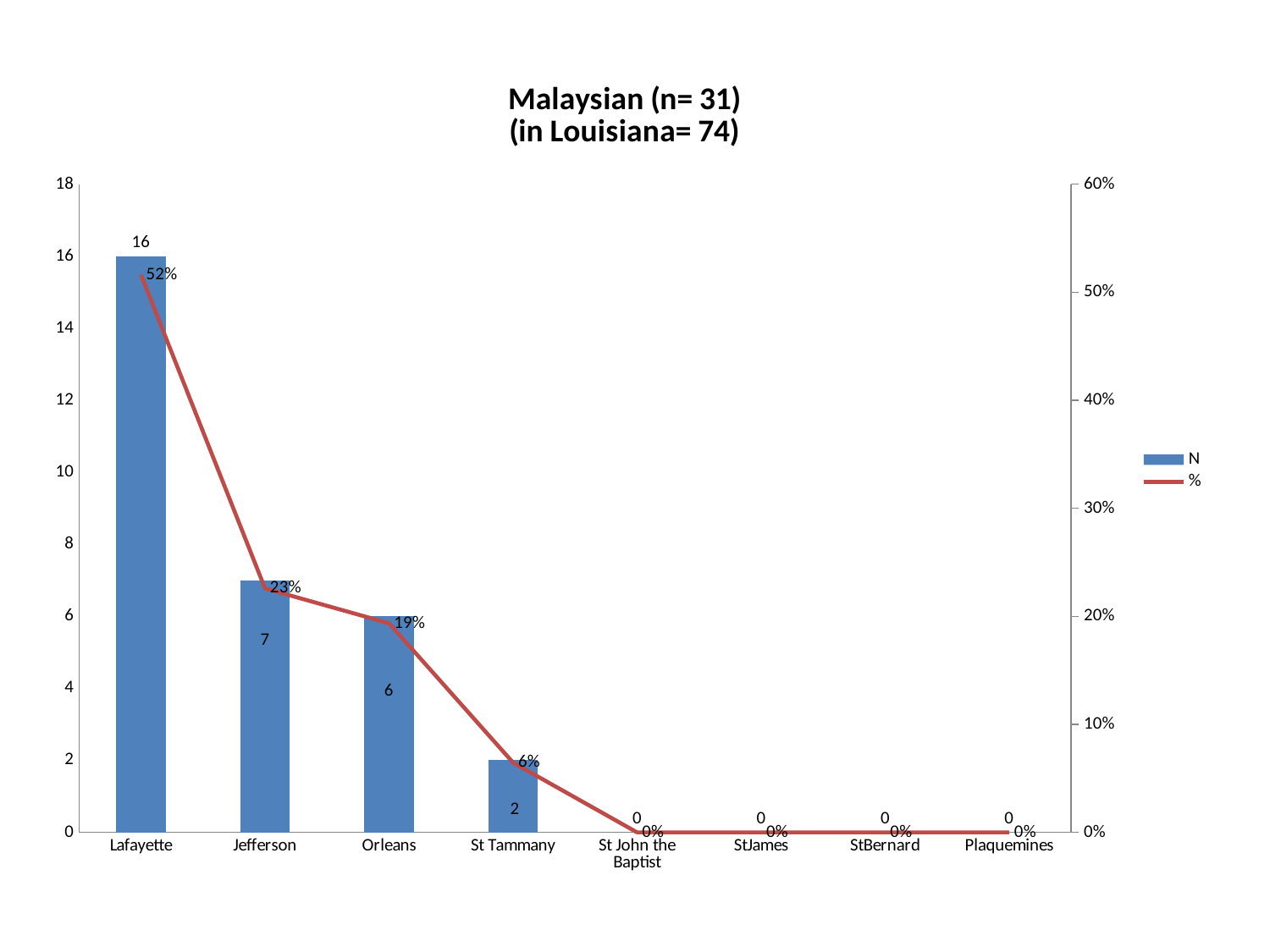
Do the % values rise or fall from Lafayette to Plaquemines along the x axis? Fall What is the N value for Lafayette? 16 How many categories are shown on the x axis? 8 Which category has the highest N value? Lafayette What is the title of the chart? Malaysian (n= 31) (in Louisiana= 74) What is the N value for Orleans? 6 What is the % value for St Tammany? 6% What is the % value for Jefferson? 23% How many series does the legend list? 2 What is the difference between the N values for Lafayette and Jefferson? 9 What kind of chart is this? Combined bar and line chart Which has a larger N value, Jefferson or Orleans? Jefferson